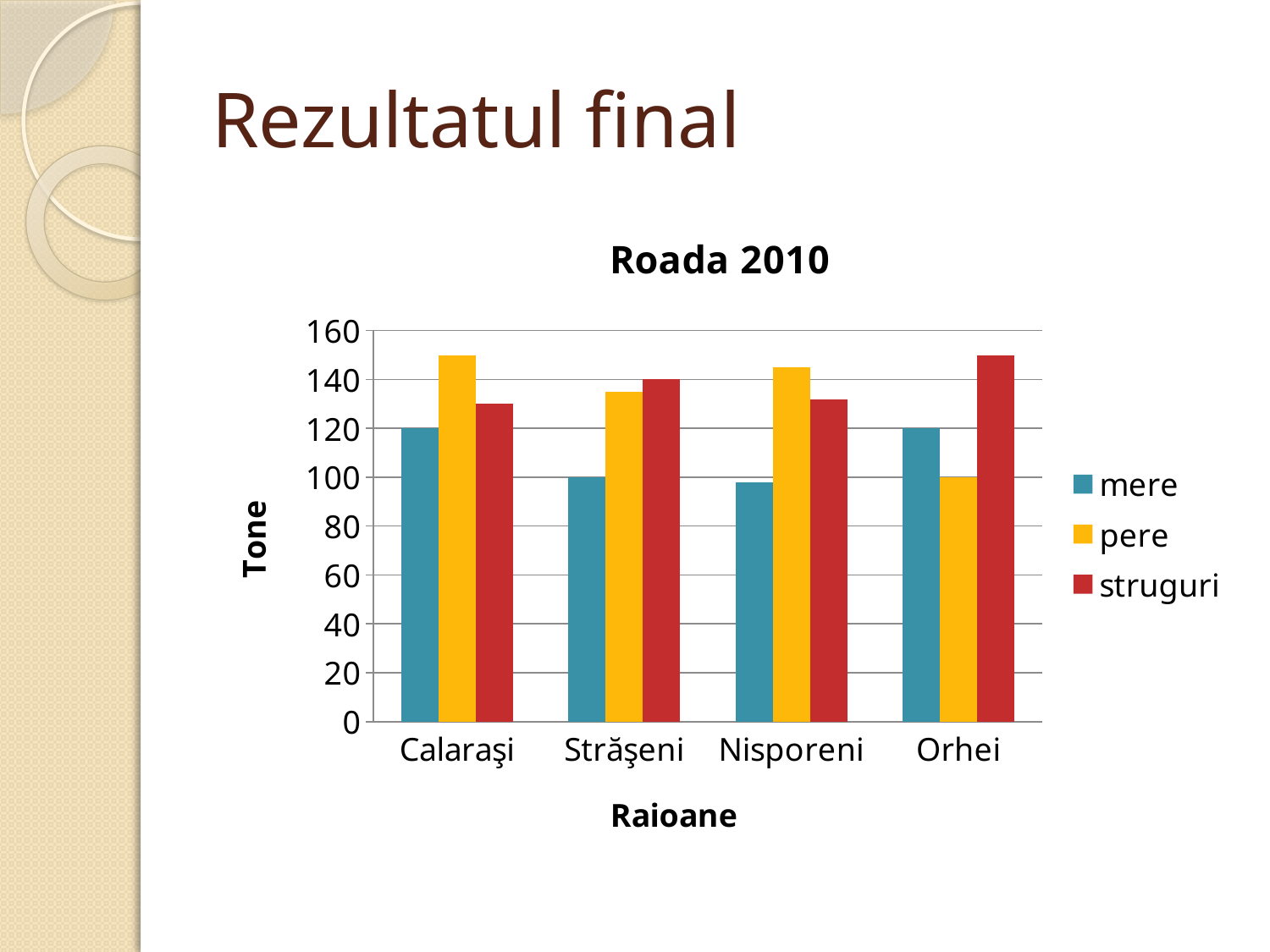
Which raion has the lowest value for pere? Orhei What is the title of the chart? Roada 2010 Which raion has the highest value for struguri? Orhei What is the value for mere in Calaraşi? 120 What type of chart is shown on the slide? bar chart What is the value for struguri in Străşeni? 140 What is the value for pere in Orhei? 100 In Orhei, which is larger: mere or pere? mere How many series does the legend list? 3 Is the value for pere in Calaraşi greater or less than 140? greater How many raioane (categories) are shown on the x axis? 4